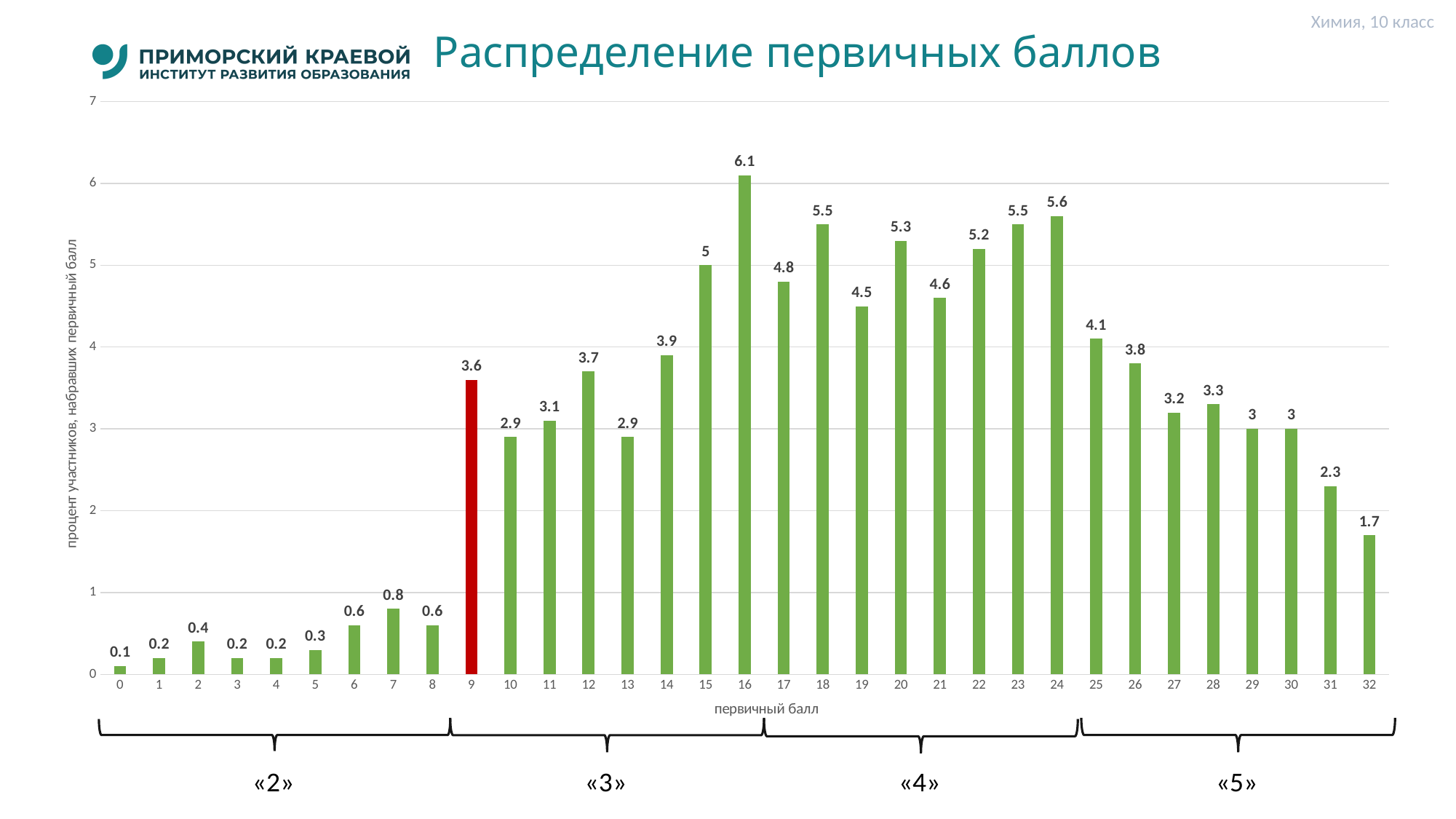
How many primary score categories are plotted on the x axis? 33 Which primary score has the highest percentage of participants? 16 What is the title of the chart? Распределение первичных баллов What is the value for primary score 9, the red bar? 3.6 Is the value for primary score 15 greater or less than 4? greater What is the value for primary score 16? 6.1 What is the difference between the values for primary scores 16 and 24? 0.5 Which primary score has the lowest percentage of participants? 0 Which is larger, the value for primary score 18 or for primary score 20? 18 What type of chart is shown on the slide? bar chart Do the values rise or fall from primary score 25 to primary score 32? fall What is the value for primary score 32? 1.7